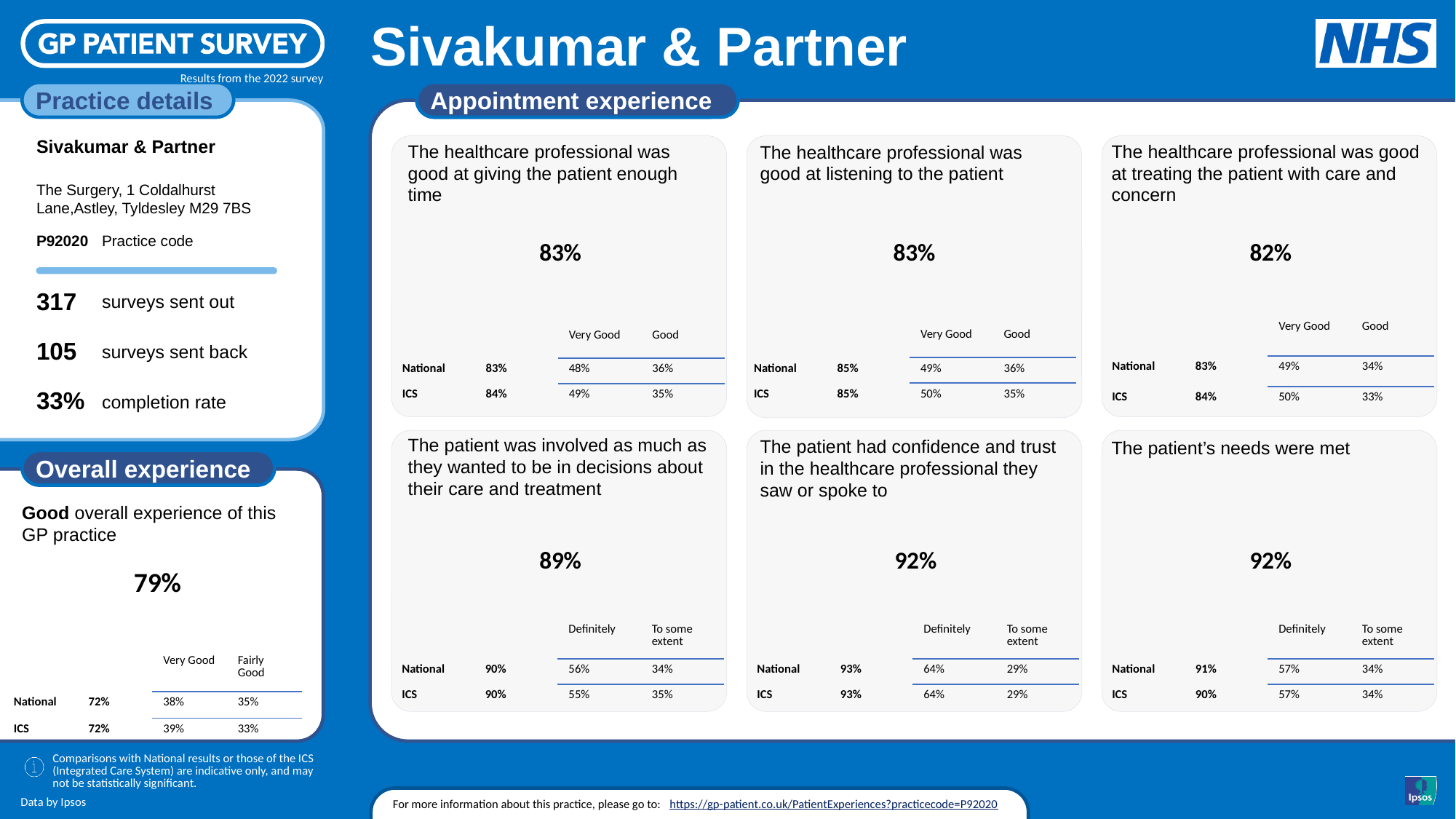
In the panel 'The patient had confidence and trust in the healthcare professional they saw or spoke to', what is the National 'Definitely' percentage? 64% How many question panels are shown in the 'Appointment experience' section? 6 In the 'Overall experience' panel, what are the two column headings in the comparison table? Very Good and Fairly Good In the 'Overall experience' panel, what is the difference between the practice's 79% and the National 72%? 7 percentage points In the 'Overall experience' panel, what is the National figure for good overall experience? 72% In the 'Overall experience' panel, what is the ICS 'Very Good' percentage? 39% In the 'Appointment experience' section, what percentage is shown for 'The patient's needs were met'? 92% In the 'Appointment experience' section, what percentage is shown for 'The healthcare professional was good at listening to the patient'? 83% Which 'Appointment experience' panel shows the lowest practice percentage? The healthcare professional was good at treating the patient with care and concern In the panel 'The patient was involved as much as they wanted to be in decisions about their care and treatment', is the practice's 89% higher or lower than the National 90%? lower In the panel 'The healthcare professional was good at treating the patient with care and concern', what is the ICS 'Good' percentage? 33% In the 'Overall experience' panel, what percentage of patients reported a good overall experience of this GP practice? 79%